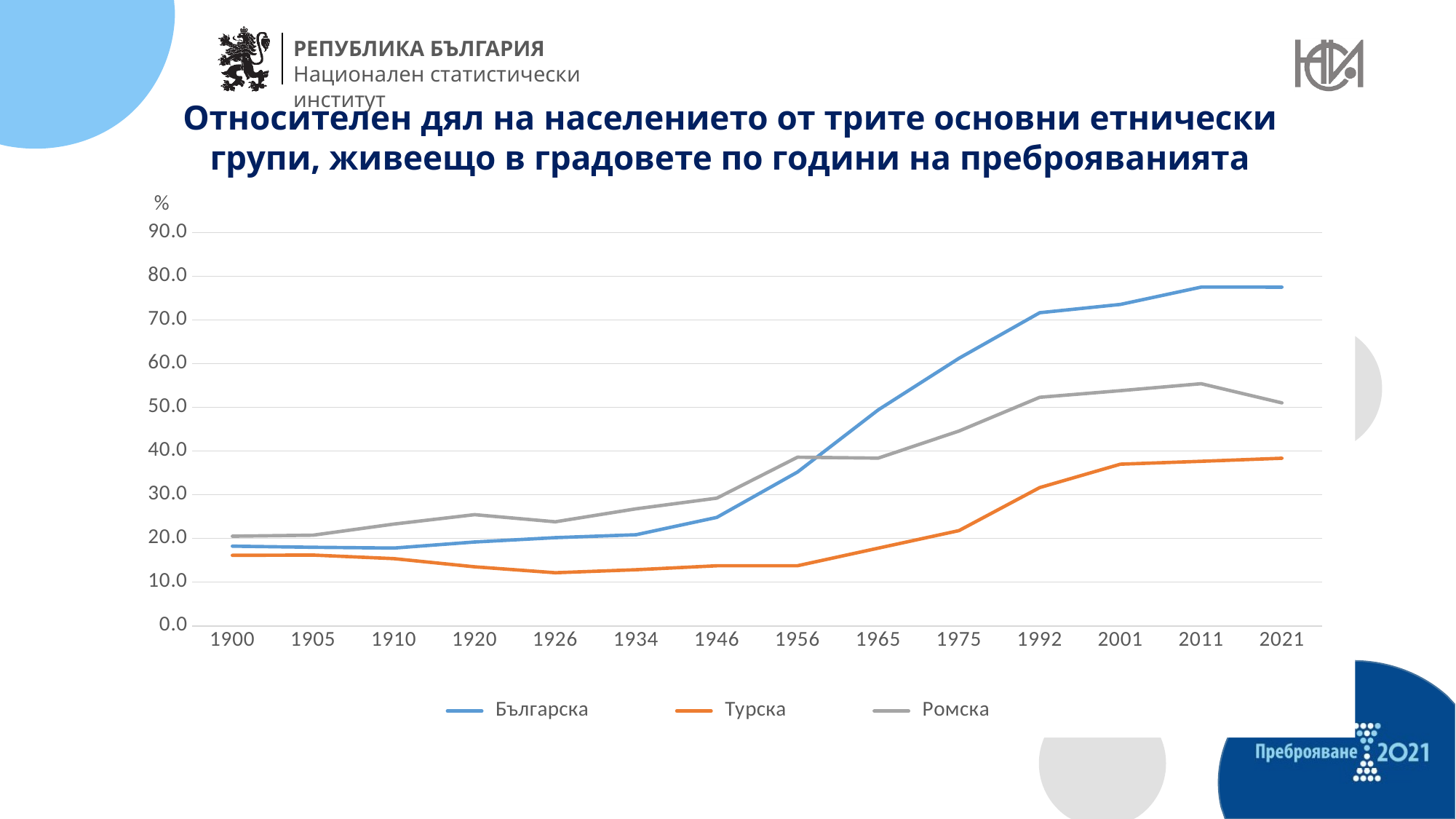
How many series does the legend list? 3 Which series has the lowest value in 1900? Турска How many census years are shown on the x axis? 14 What kind of chart is shown on the slide? line chart Does the value for Българска generally rise or fall from 1900 to 2021? rise Which series has the lowest value in 2021? Турска Which series is drawn in orange? Турска Is the value for Ромска in 1992 greater or less than 50.0? greater Which series has the highest value in 2021? Българска Is the value for Турска in 1926 greater or less than 20.0? less In 1975, which is larger: the value for Българска or the value for Ромска? Българска Is the value for Българска in 2021 greater or less than 70.0? greater